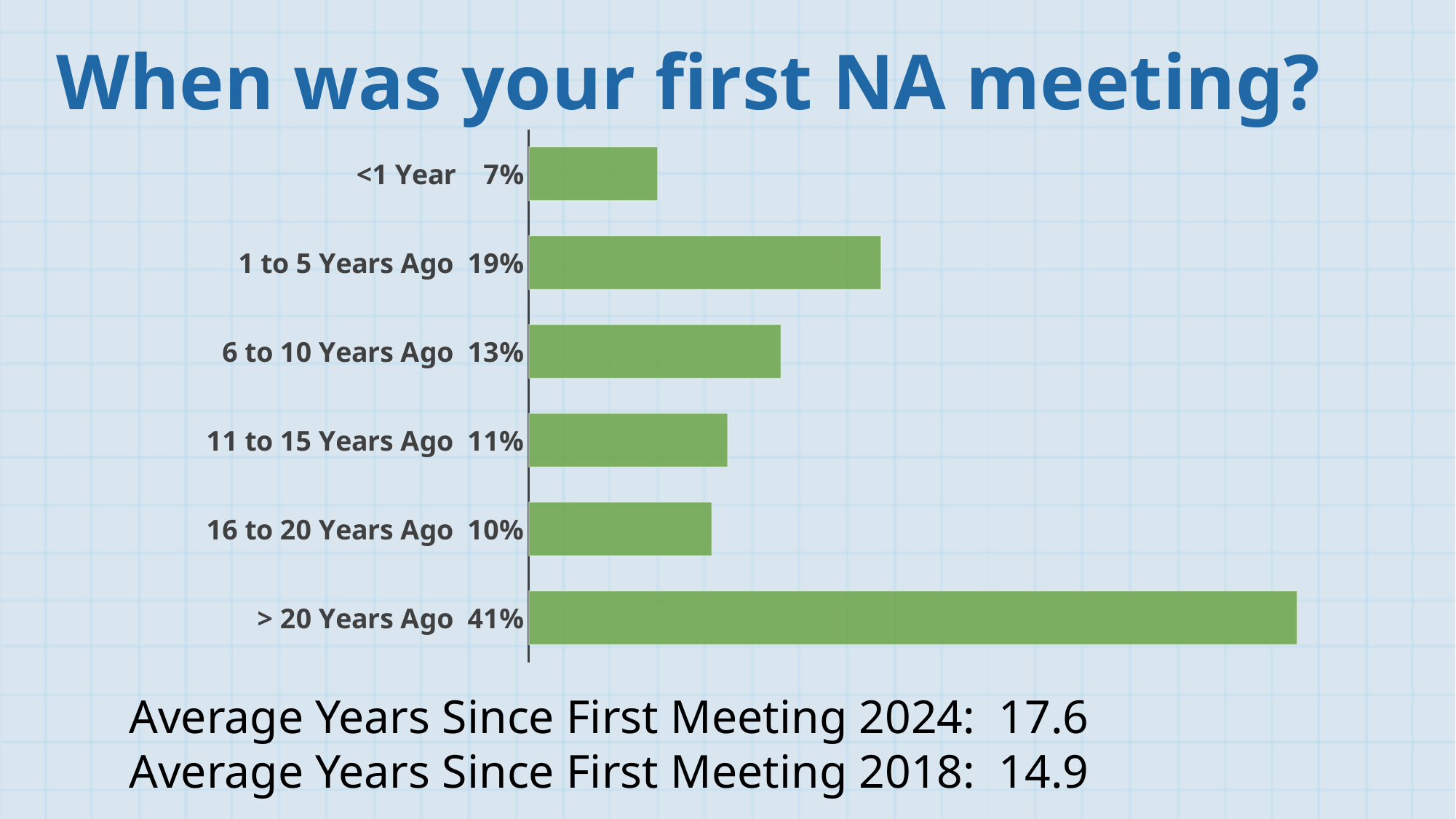
What percentage of respondents had their first NA meeting 1 to 5 years ago? 19% What is the difference in percentage points between '6 to 10 Years Ago' and '11 to 15 Years Ago'? 2 What percentage of respondents had their first NA meeting less than 1 year ago? 7% Which category has the lowest percentage? <1 Year Which category has the highest percentage? > 20 Years Ago What percentage of respondents had their first NA meeting 16 to 20 years ago? 10% What is the difference in percentage points between '> 20 Years Ago' and '1 to 5 Years Ago'? 22 What colour are the bars in the chart? Green Which is larger: the percentage for '6 to 10 Years Ago' or '16 to 20 Years Ago'? 6 to 10 Years Ago How many categories are shown in the chart? 6 What is the title of the slide? When was your first NA meeting? What kind of chart is shown on the slide? Bar chart